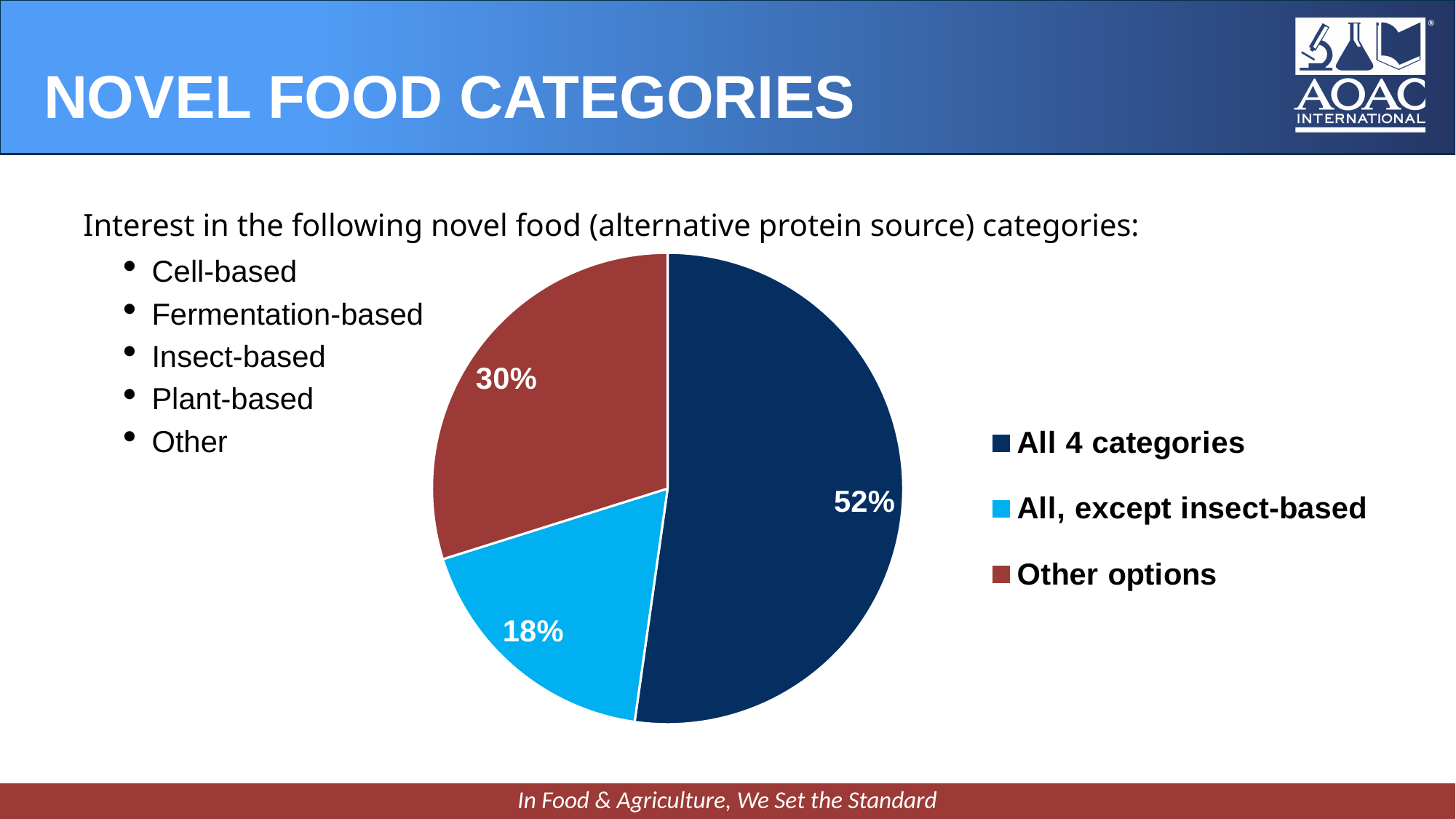
How many slices does the pie chart have? 3 What kind of chart is shown on the slide? Pie chart Which slice of the pie is the largest? All 4 categories What colour is the "Other options" slice in the pie chart? Dark red What share of the pie is labelled "Other options"? 30% What is the difference in percentage points between the "All 4 categories" slice and the "Other options" slice? 22 How many entries does the legend list? 3 Which is larger: the "Other options" slice or the "All, except insect-based" slice? Other options What is the difference in percentage points between the "Other options" slice and the "All, except insect-based" slice? 12 What share of the pie is labelled "All 4 categories"? 52% What share of the pie is labelled "All, except insect-based"? 18% Which slice of the pie is the smallest? All, except insect-based